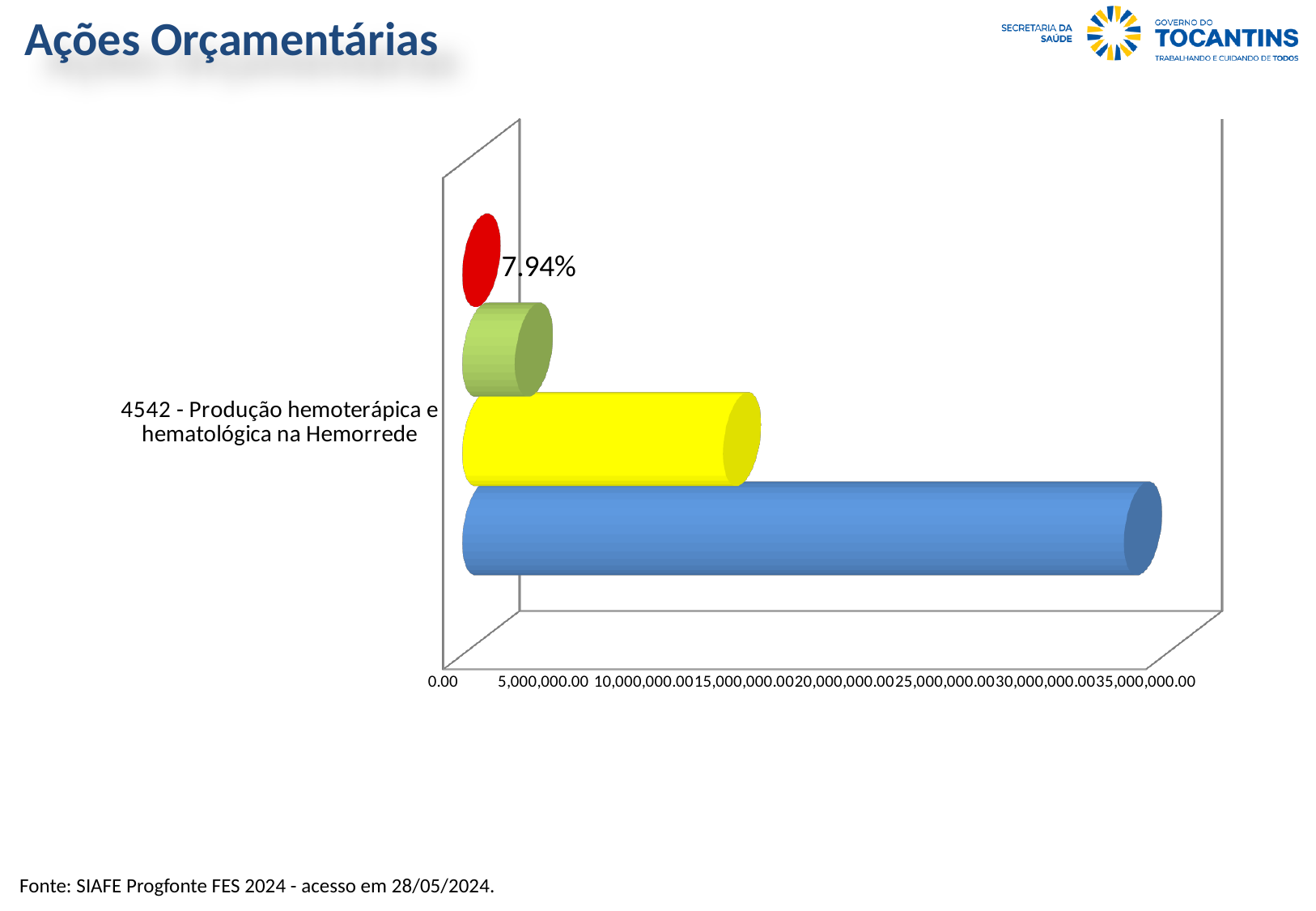
What percentage value is printed as a data label next to the red bar? 7.94% Is the value of the yellow bar greater or less than 20,000,000.00? less What is the title shown at the top of the slide? Ações Orçamentárias Is the value of the yellow bar greater or less than 10,000,000.00? greater How many categories are shown on the vertical axis of the chart? 1 Which coloured bar is the shortest in the chart? red What is the category label shown on the chart? 4542 - Produção hemoterápica e hematológica na Hemorrede Is the value of the green bar greater or less than 10,000,000.00? less Which is larger, the blue bar or the yellow bar? blue Which coloured bar is the longest in the chart? blue What kind of chart is shown on the slide? bar chart